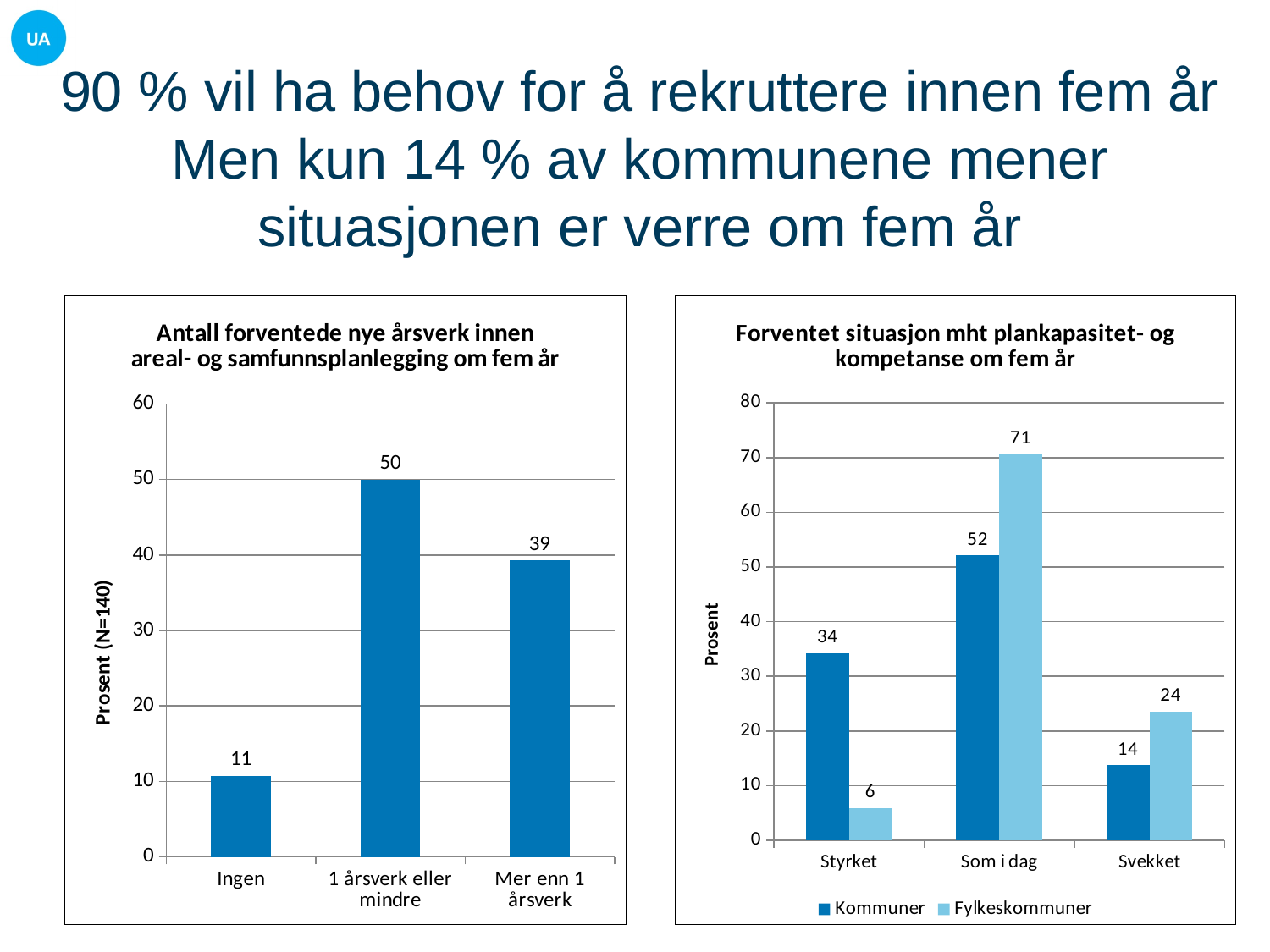
In the left chart 'Antall forventede nye årsverk innen areal- og samfunnsplanlegging om fem år', what is the y-axis label? Prosent (N=140) In the right chart 'Forventet situasjon mht plankapasitet- og kompetanse om fem år', how many series does the legend list? 2 What type of chart is the right chart 'Forventet situasjon mht plankapasitet- og kompetanse om fem år'? Bar chart In the right chart 'Forventet situasjon mht plankapasitet- og kompetanse om fem år', what is the difference between Fylkeskommuner and Kommuner in 'Som i dag'? 19 In the left chart 'Antall forventede nye årsverk innen areal- og samfunnsplanlegging om fem år', what is the difference between '1 årsverk eller mindre' and 'Mer enn 1 årsverk'? 11 In the right chart 'Forventet situasjon mht plankapasitet- og kompetanse om fem år', what is the value for Kommuner in 'Svekket'? 14 In the left chart 'Antall forventede nye årsverk innen areal- og samfunnsplanlegging om fem år', how many categories are shown on the x axis? 3 In the right chart 'Forventet situasjon mht plankapasitet- og kompetanse om fem år', what is the value for Fylkeskommuner in 'Som i dag'? 71 In the right chart 'Forventet situasjon mht plankapasitet- og kompetanse om fem år', which category has the highest value for Kommuner? Som i dag In the left chart 'Antall forventede nye årsverk innen areal- og samfunnsplanlegging om fem år', what is the value for '1 årsverk eller mindre'? 50 In the right chart 'Forventet situasjon mht plankapasitet- og kompetanse om fem år', which is larger for 'Styrket': Kommuner or Fylkeskommuner? Kommuner In the left chart 'Antall forventede nye årsverk innen areal- og samfunnsplanlegging om fem år', which category has the lowest value? Ingen